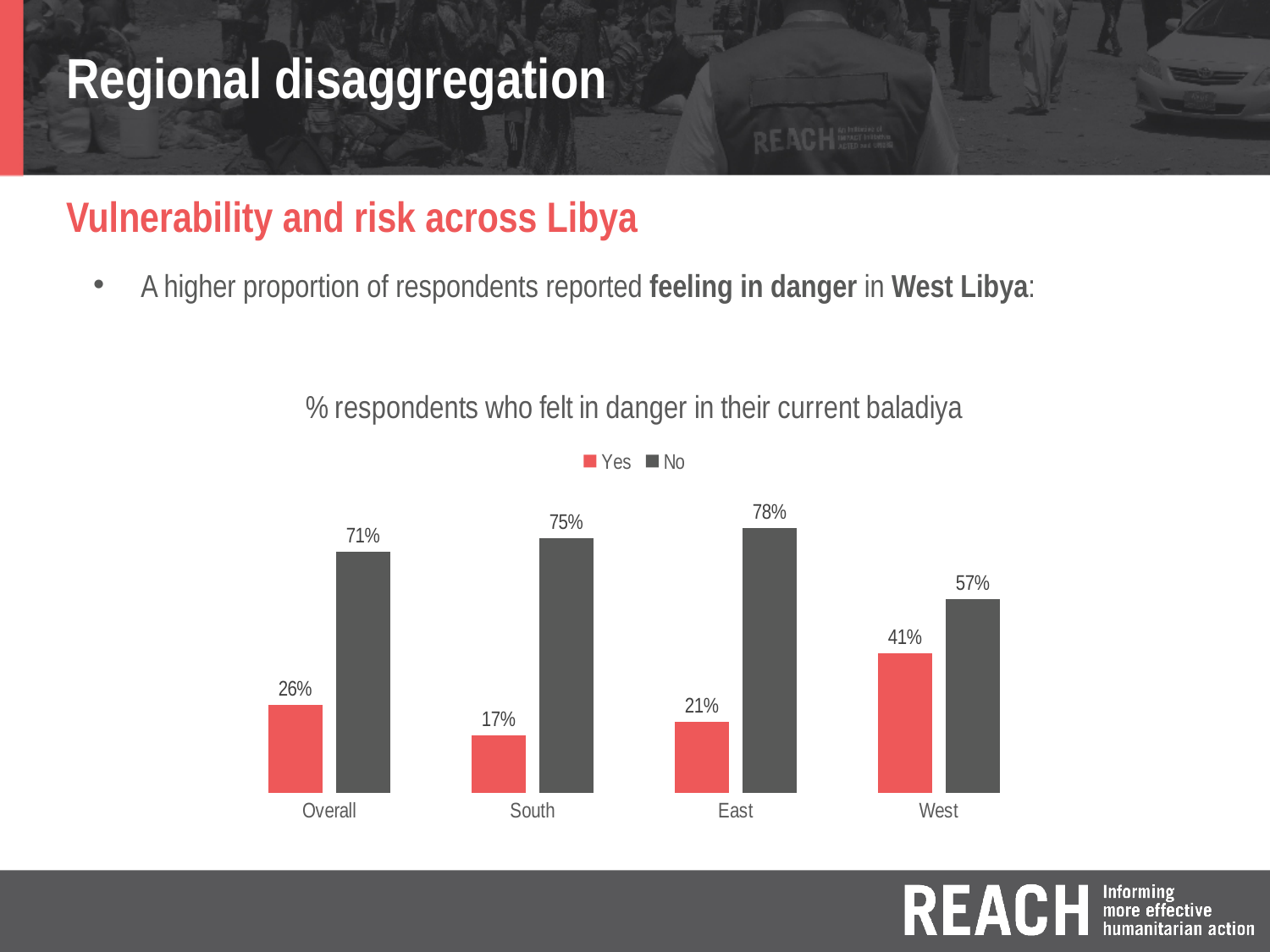
Which region has the lowest Yes value? South How many categories are shown on the x axis? 4 How many series does the legend list? 2 What is the Yes value for the South region? 17% Which region has the highest Yes value? West What type of chart is shown on the slide? Bar chart Which region has the lowest No value? West What is the No value for the East region? 78% What percentage of respondents in the West answered Yes to feeling in danger? 41% Is the Yes value higher for the East or the West? West What is the difference between the No and Yes values for the Overall category? 45% What is the title of the chart? % respondents who felt in danger in their current baladiya